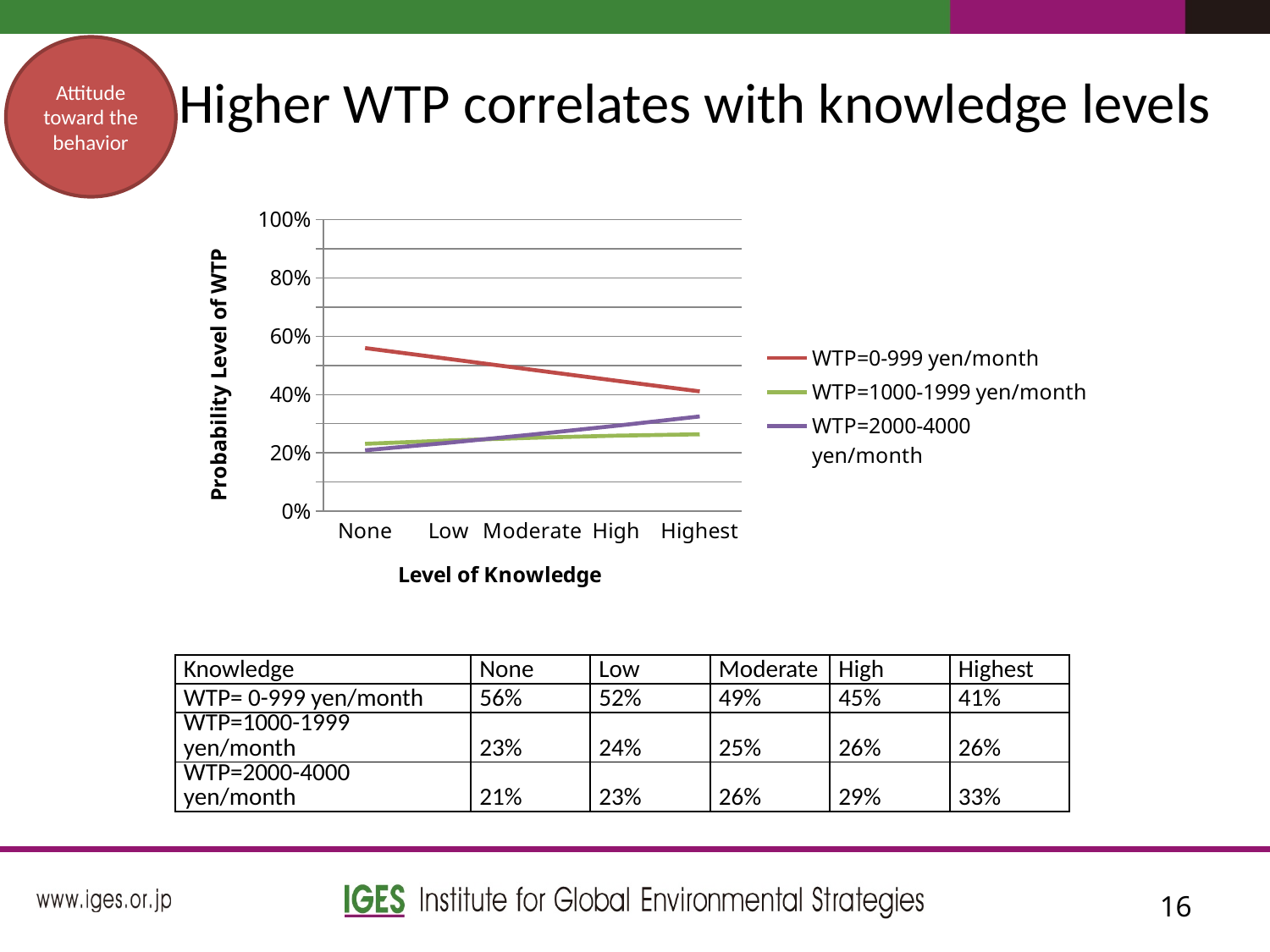
How many series does the chart legend list? 3 What is the value for WTP=0-999 yen/month at the None knowledge level? 56% What is the difference between the WTP=0-999 yen/month values at None and Highest knowledge levels? 15% Which series has the highest value at the None knowledge level? WTP=0-999 yen/month Which series has the lowest value at the None knowledge level? WTP=2000-4000 yen/month What is the value for WTP=2000-4000 yen/month at the Highest knowledge level? 33% Is the value for WTP=0-999 yen/month at the Highest knowledge level greater or less than 60%? less What kind of chart is shown on the slide? line chart Does the WTP=2000-4000 yen/month series rise or fall as the level of knowledge increases from None to Highest? rise Does the WTP=0-999 yen/month series rise or fall as the level of knowledge increases from None to Highest? fall What is the value for WTP=1000-1999 yen/month at the Moderate knowledge level? 25% How many knowledge levels are shown along the x axis of the chart? 5